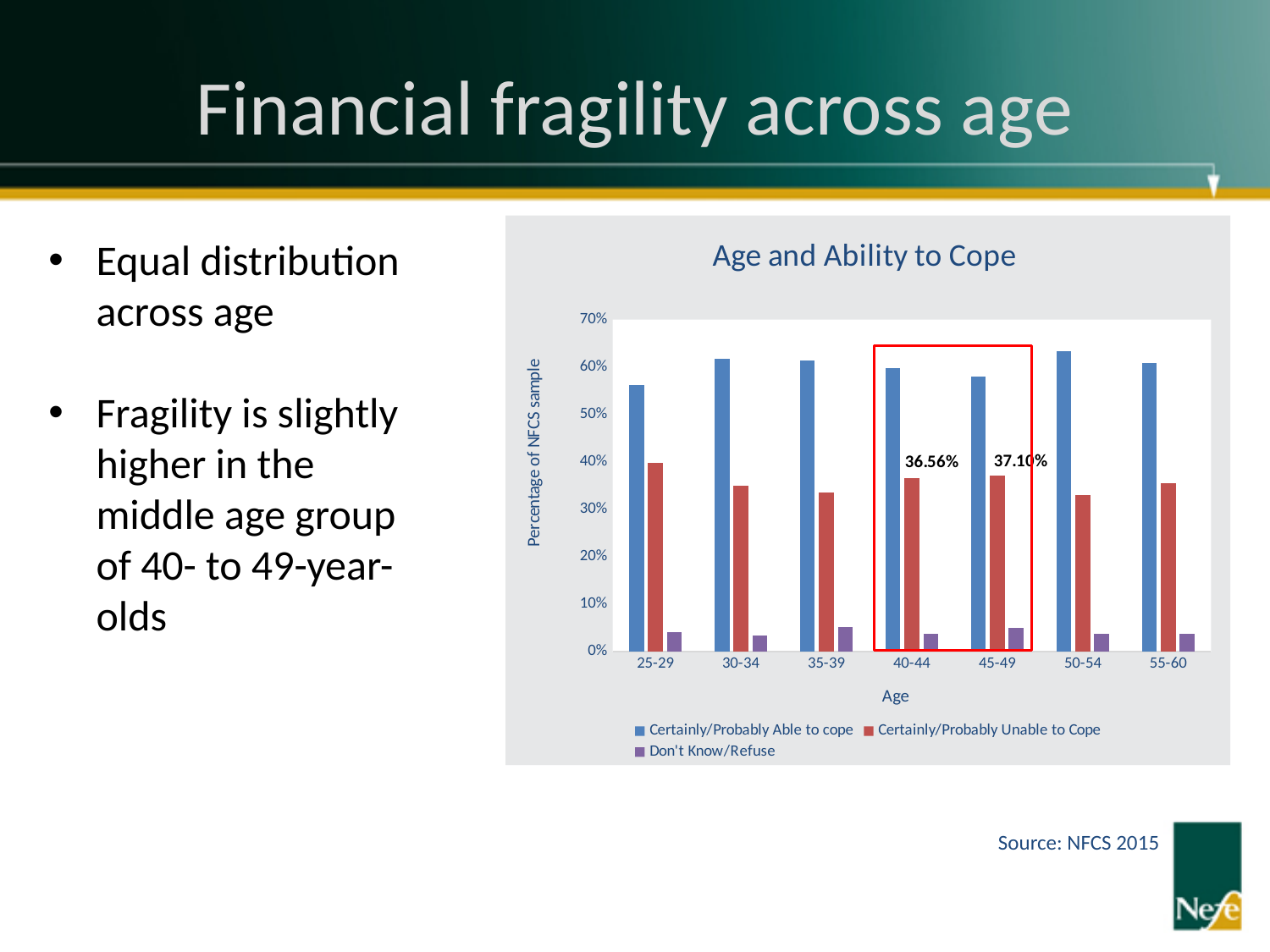
What kind of chart is shown on the slide? Bar chart What is the difference between the Certainly/Probably Unable to Cope values for the 45-49 and 40-44 age groups? 0.54% What is the title of the chart? Age and Ability to Cope What is the value for Certainly/Probably Unable to Cope in the 40-44 age group? 36.56% What is the value for Certainly/Probably Unable to Cope in the 45-49 age group? 37.10% Is the Certainly/Probably Able to cope value for the 25-29 age group greater or less than 50%? greater Which age group has the larger Certainly/Probably Unable to Cope value, 40-44 or 45-49? 45-49 How many series does the chart's legend list? 3 Is the Don't Know/Refuse value for the 35-39 age group greater or less than 10%? less Which age group has the highest Certainly/Probably Unable to Cope value? 25-29 Which age group has the lowest Certainly/Probably Able to cope value? 25-29 How many age groups are shown on the x axis of the chart? 7